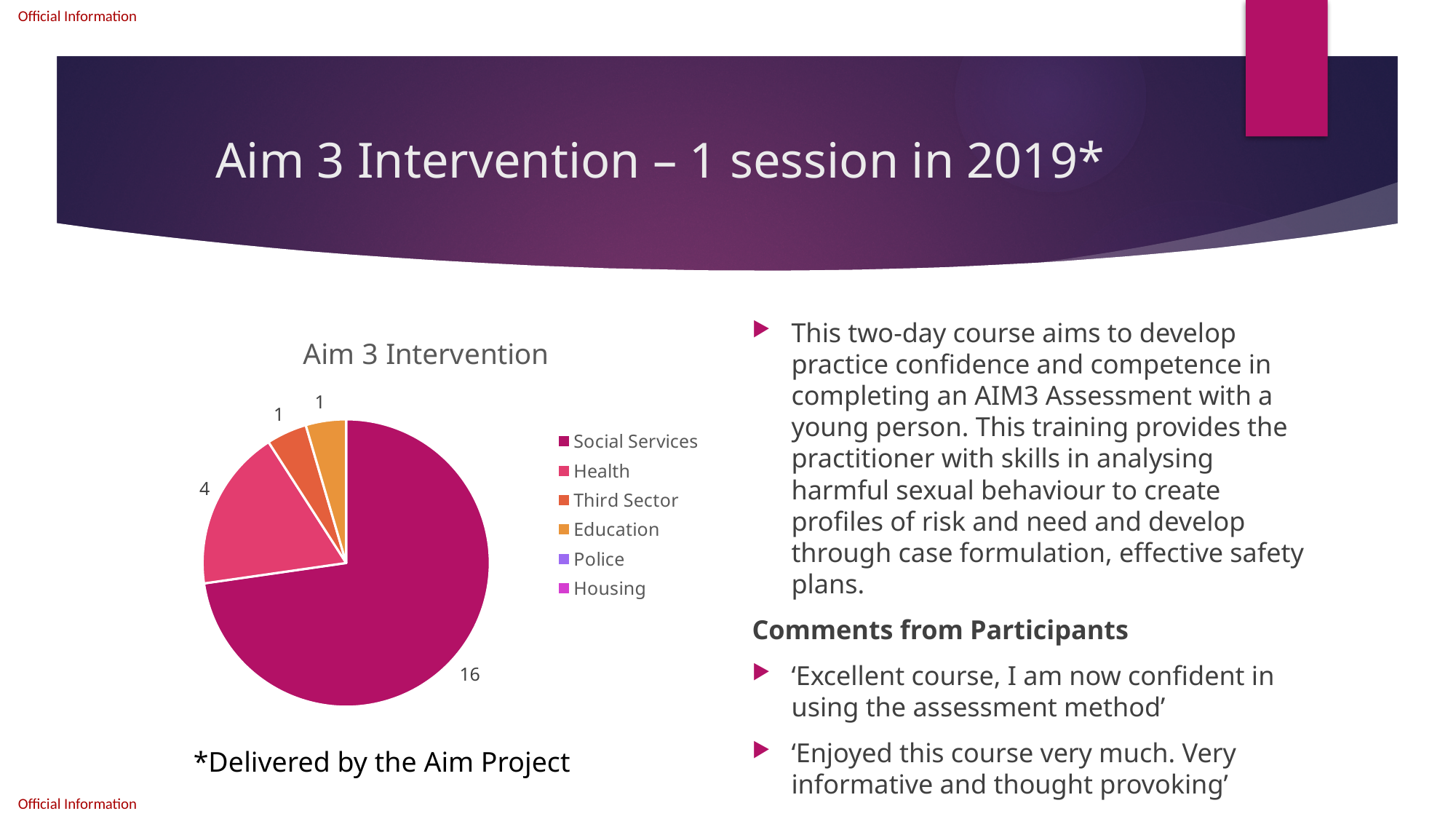
What is the value for Social Services in the Aim 3 Intervention pie chart? 16 What is the value for Education in the Aim 3 Intervention pie chart? 1 Which category has the largest slice in the Aim 3 Intervention pie chart? Social Services What is the value for Health in the Aim 3 Intervention pie chart? 4 What kind of chart is shown on the slide? Pie chart What is the title of the pie chart on the slide? Aim 3 Intervention Which is larger in the Aim 3 Intervention pie chart, Health or Third Sector? Health What is the difference between the Health and Education values in the Aim 3 Intervention pie chart? 3 How many categories does the legend of the Aim 3 Intervention chart list? 6 What is the value for Third Sector in the Aim 3 Intervention pie chart? 1 How many slices with data labels are visible in the Aim 3 Intervention pie chart? 4 What is the difference between the Social Services and Health values in the Aim 3 Intervention pie chart? 12